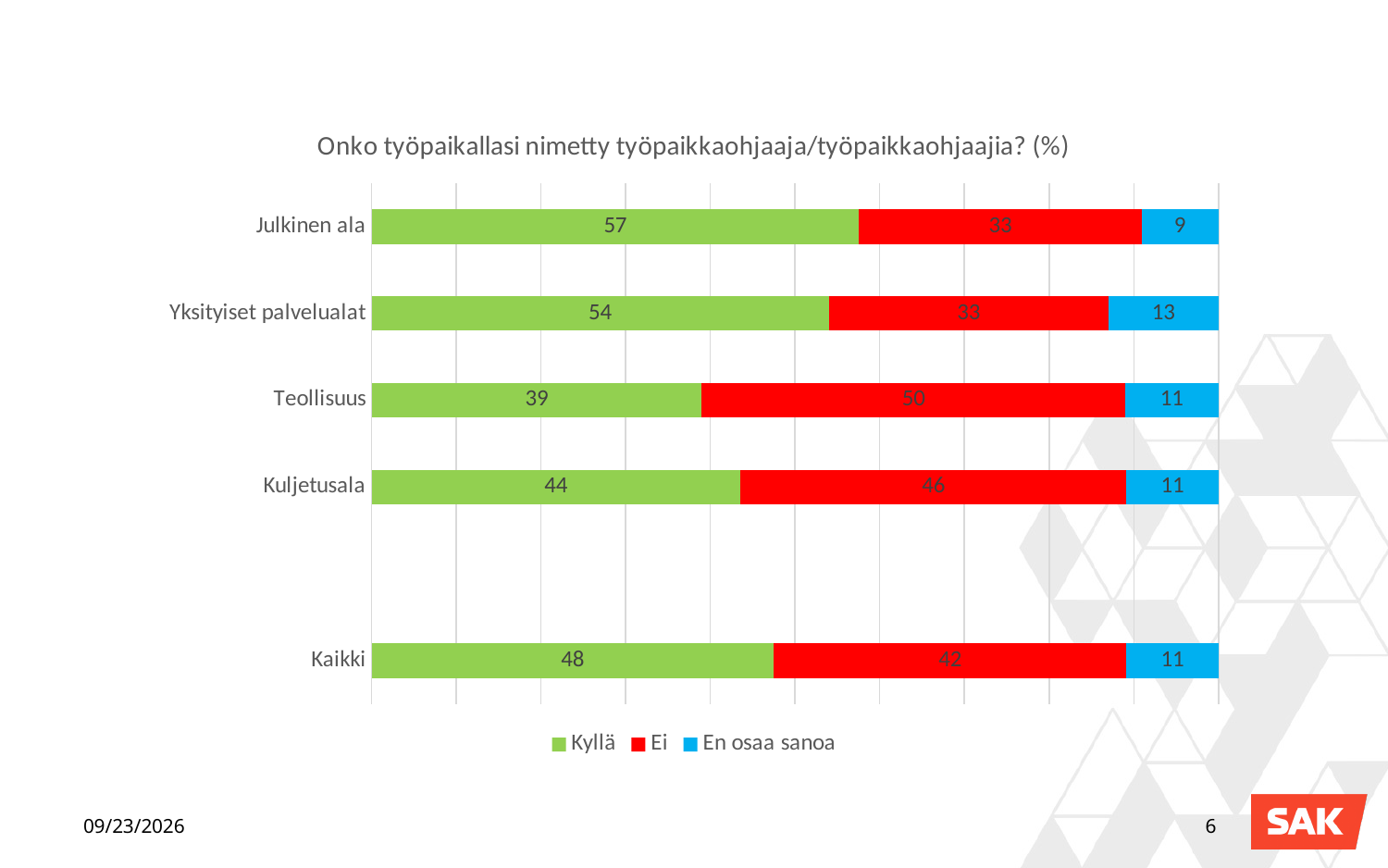
Which category has the lowest Kyllä value? Teollisuus What is the difference between the Ei value for Teollisuus and the Ei value for Julkinen ala? 17 What kind of chart is shown on the slide? Stacked bar chart What is the En osaa sanoa value for Yksityiset palvelualat? 13 What is the total of the stacked bar for Kuljetusala? 101 Which is larger: the Kyllä value for Kuljetusala or the Ei value for Kuljetusala? Ei How many categories are shown on the chart? 5 Which category has the highest Kyllä value? Julkinen ala What is the Kyllä value for Kaikki? 48 What is the Kyllä value for Julkinen ala? 57 How many series does the legend list? 3 What is the Ei value for Teollisuus? 50